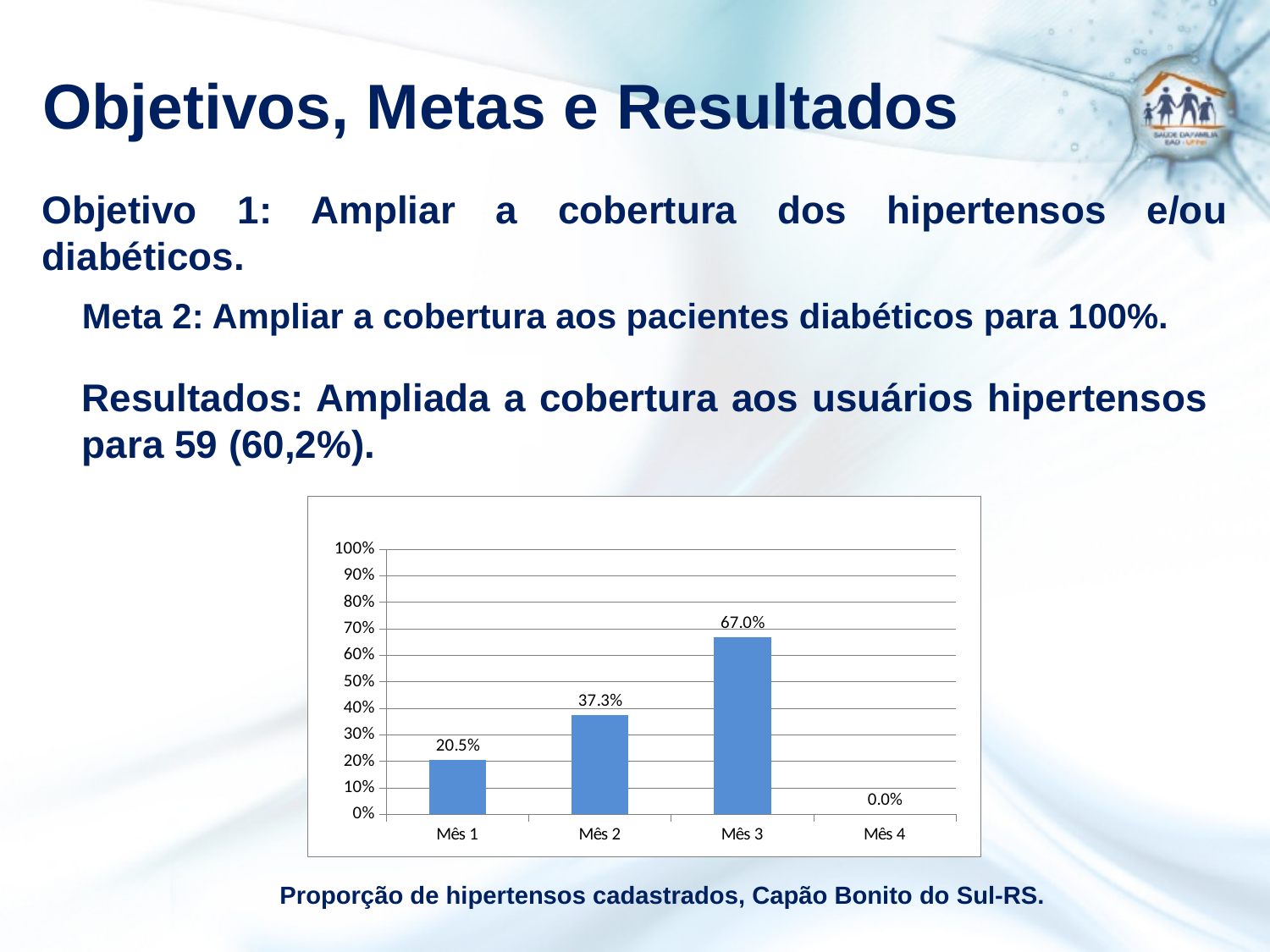
What is the value for Mês 1? 20.5% What kind of chart is shown on the slide? bar chart What is the value for Mês 4? 0.0% What is the difference between the values for Mês 3 and Mês 2? 29.7% What is the value for Mês 2? 37.3% Which month has the highest value? Mês 3 Is the value for Mês 3 greater or less than 60%? greater Which is larger, the value for Mês 1 or the value for Mês 2? Mês 2 Which month has the lowest value? Mês 4 How many months are shown on the x axis? 4 What is the value for Mês 3? 67.0% Do the values rise or fall from Mês 1 to Mês 3? rise